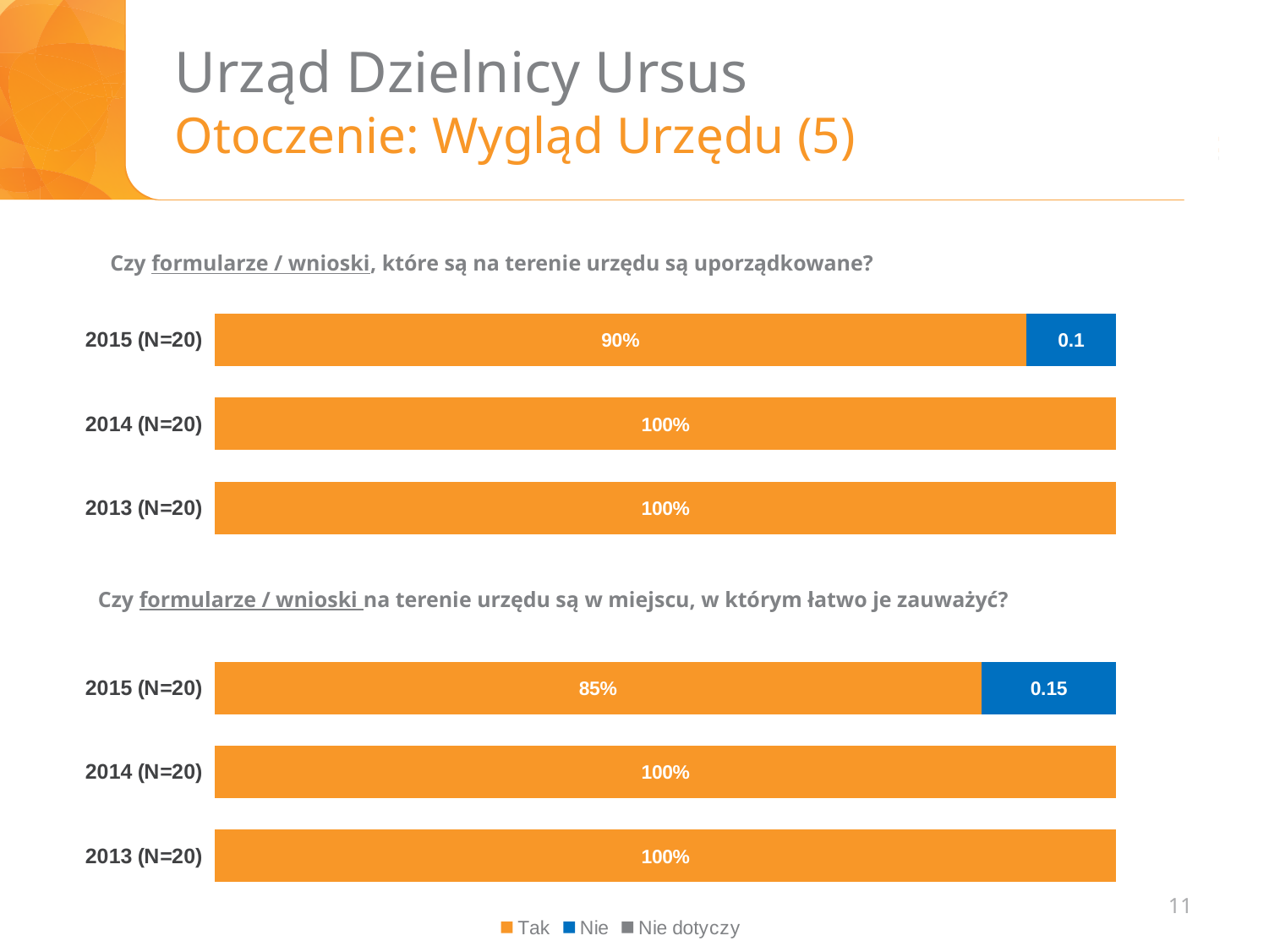
In the bottom chart, what is the difference between the 'Tak' value for 2014 (N=20) and the 'Tak' value for 2015 (N=20)? 15% In the bottom chart, what is the 'Tak' value for 2015 (N=20)? 85% In the bottom chart, which year has the lowest 'Tak' value? 2015 (N=20) In the top chart, what is the 'Tak' value for 2015 (N=20)? 90% In the top chart, what is the 'Tak' value for 2014 (N=20)? 100% How many series does the legend list? 3 In the bottom chart, what is the 'Tak' value for 2013 (N=20)? 100% In the bottom chart, what is the 'Nie' value shown for 2015 (N=20)? 0.15 What type of chart is used on this slide? stacked bar chart Is the 'Tak' value for 2015 larger in the top chart or in the bottom chart? top chart In the top chart, which year has the lowest 'Tak' value? 2015 (N=20) In the top chart, what is the 'Nie' value shown for 2015 (N=20)? 0.1